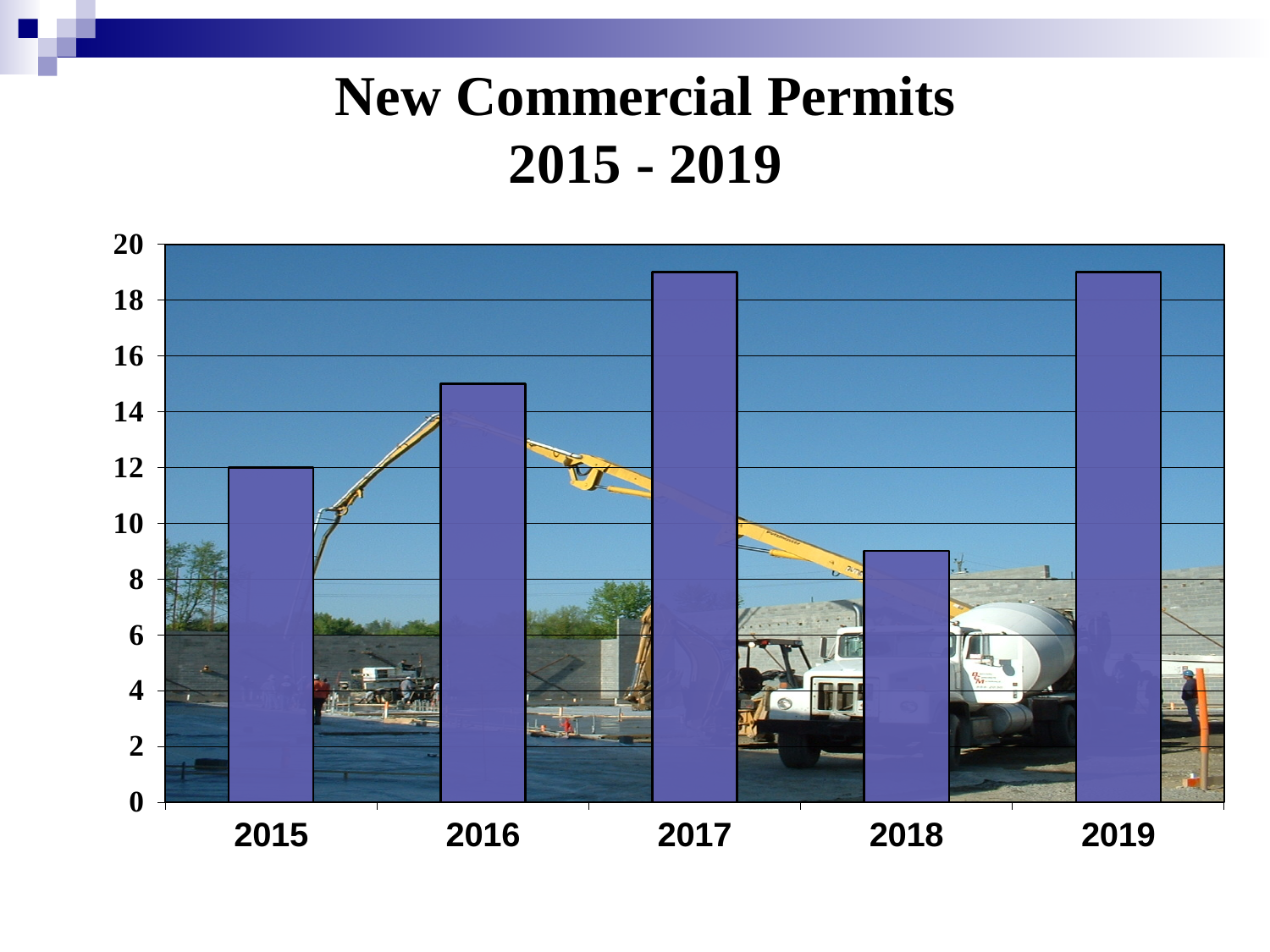
Which year has the larger value, 2015 or 2016? 2016 Is the value for 2019 greater or less than 20? less Which year has the larger value, 2018 or 2015? 2015 Is the value for 2018 greater or less than 10? less What is the title of the chart? New Commercial Permits 2015 - 2019 Is the value for 2017 greater or less than 18? greater What is the value for 2015? 12 How many years are shown on the x axis of the chart? 5 Which year has the lowest number of new commercial permits? 2018 Do the values rise or fall from 2017 to 2018? fall What type of chart is shown on the slide? Bar chart